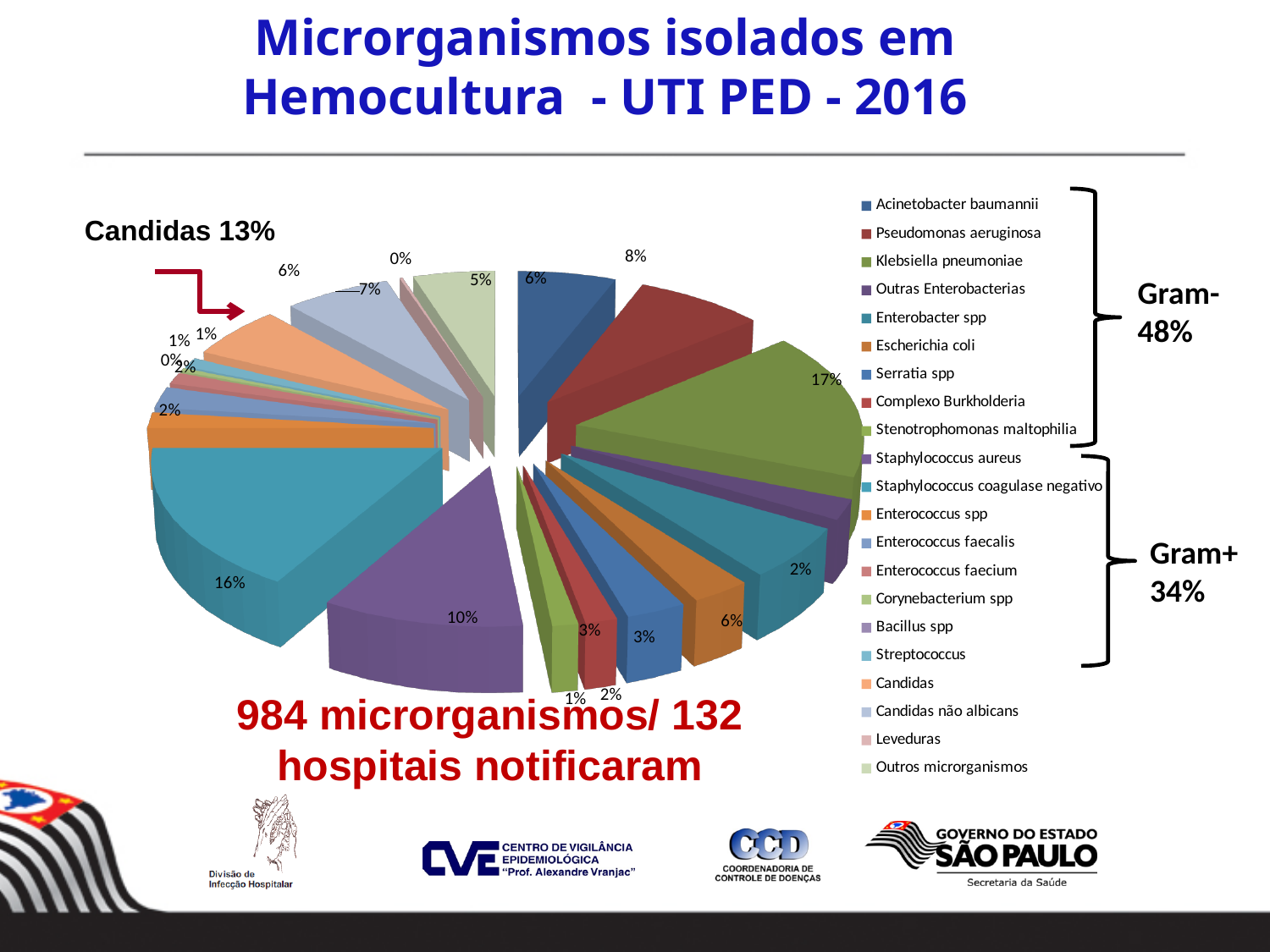
What percentage of the pie does Staphylococcus aureus represent? 10% What percentage of the pie does Staphylococcus coagulase negativo represent? 16% Which slice is larger, Klebsiella pneumoniae or Staphylococcus aureus? Klebsiella pneumoniae What kind of chart is shown on the slide? pie chart Which microorganism has the largest slice of the pie? Klebsiella pneumoniae What is the title of the chart on the slide? Microrganismos isolados em Hemocultura - UTI PED - 2016 What percentage of the pie does Klebsiella pneumoniae represent? 17% What total share is annotated for the Gram+ group on the slide? 34% What total share is annotated for the Gram- group on the slide? 48% What is the difference in percentage points between the Klebsiella pneumoniae slice (17%) and the Staphylococcus coagulase negativo slice (16%)? 1 How many entries does the chart legend list? 21